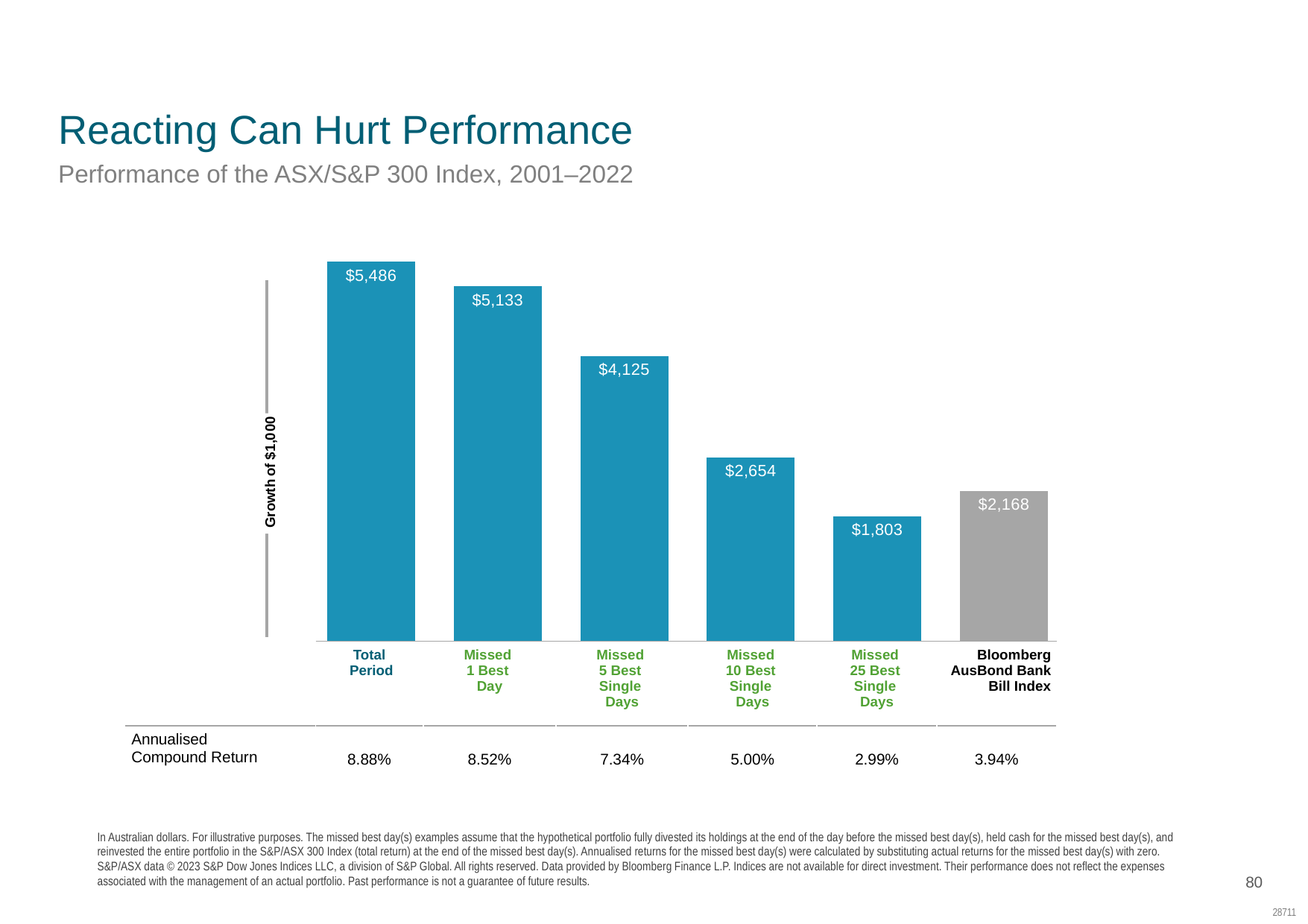
What is the growth of $1,000 for the Total Period? $5,486 What is the annualised compound return for Missed 10 Best Single Days? 5.00% How many bars are shown in the chart? 6 What kind of chart is shown on the slide? Bar chart Which is larger: the growth of $1,000 for Missed 25 Best Single Days or for the Bloomberg AusBond Bank Bill Index? Bloomberg AusBond Bank Bill Index Do the values of the blue bars rise or fall from Total Period to Missed 25 Best Single Days? Fall What is the difference in growth of $1,000 between the Total Period and Missed 1 Best Day? $353 Which category has the highest growth of $1,000? Total Period Which category has the lowest growth of $1,000? Missed 25 Best Single Days What is the growth of $1,000 when the 5 best single days are missed? $4,125 What is the label on the vertical axis of the chart? Growth of $1,000 What is the growth of $1,000 for the Bloomberg AusBond Bank Bill Index? $2,168